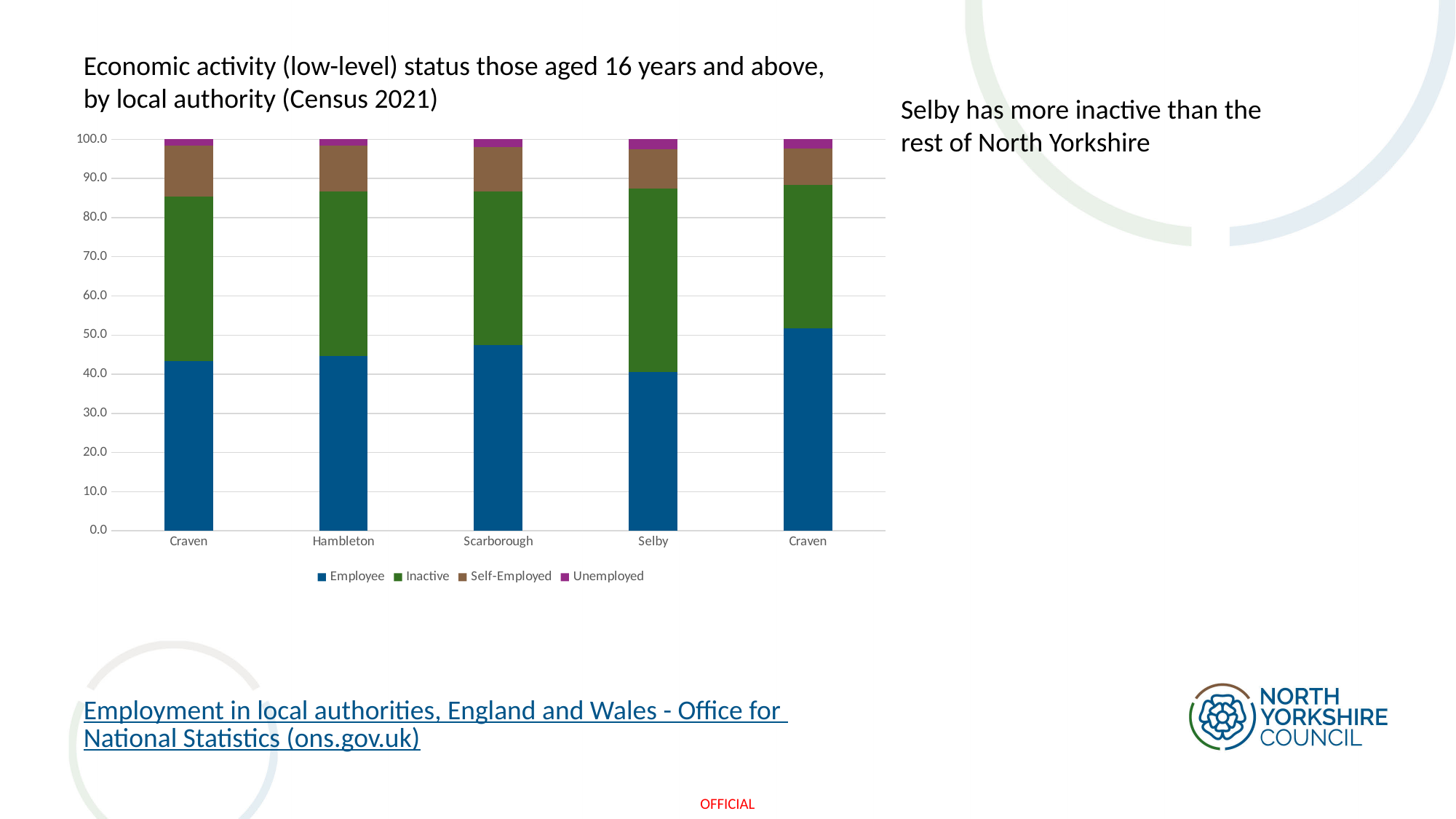
What value on the y axis does the top of each stacked bar reach? 100.0 Is the Employee value for Selby greater or less than 30.0? greater Which has the larger Employee segment, Scarborough or Selby? Scarborough How many series does the legend list? 4 What kind of chart is shown on the slide? Stacked bar chart Which series are listed in the legend? Employee, Inactive, Self-Employed, Unemployed How many bars (local authorities) are plotted on the x axis? 5 Which local authority has the smallest Employee segment? Selby Is the Employee value for Selby greater or less than 50.0? less Is the Employee value for Hambleton greater or less than 40.0? greater Which has the larger Inactive segment, Selby or Hambleton? Selby What is the title of the chart? Economic activity (low-level) status those aged 16 years and above, by local authority (Census 2021)